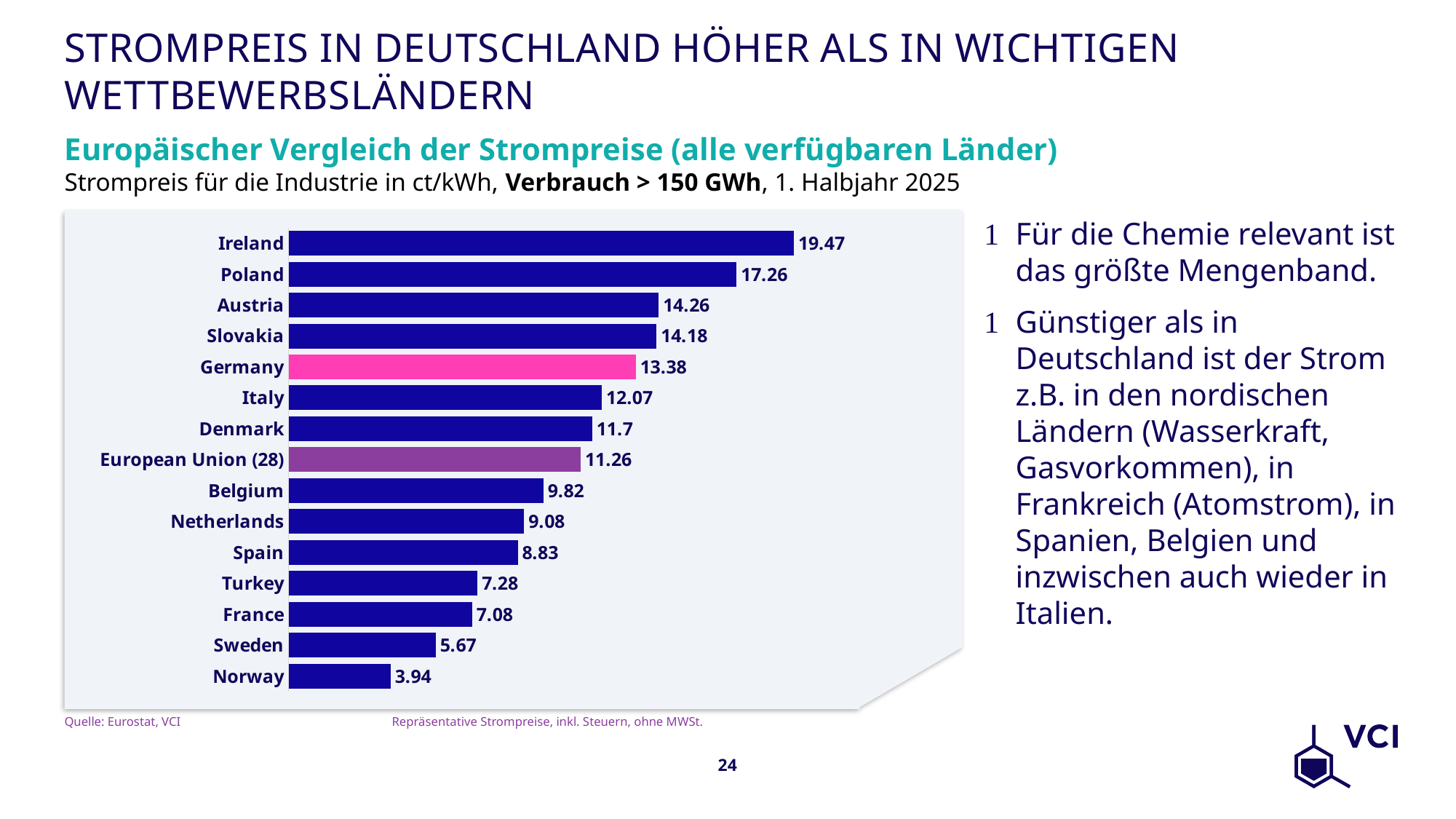
What is the electricity price for Norway? 3.94 What is the electricity price for Germany? 13.38 What is the difference between the electricity price for Germany and for France? 6.3 Which has a higher electricity price, Sweden or Turkey? Turkey What is the difference between the electricity price for Ireland and for Poland? 2.21 Which country has the highest electricity price in the chart? Ireland Which has a higher electricity price, Austria or Slovakia? Austria What is the value shown for European Union (28)? 11.26 Which bar in the chart is highlighted in pink? Germany Which country has the lowest electricity price in the chart? Norway How many countries or regions are shown in the chart? 15 What kind of chart is shown on the slide? Bar chart